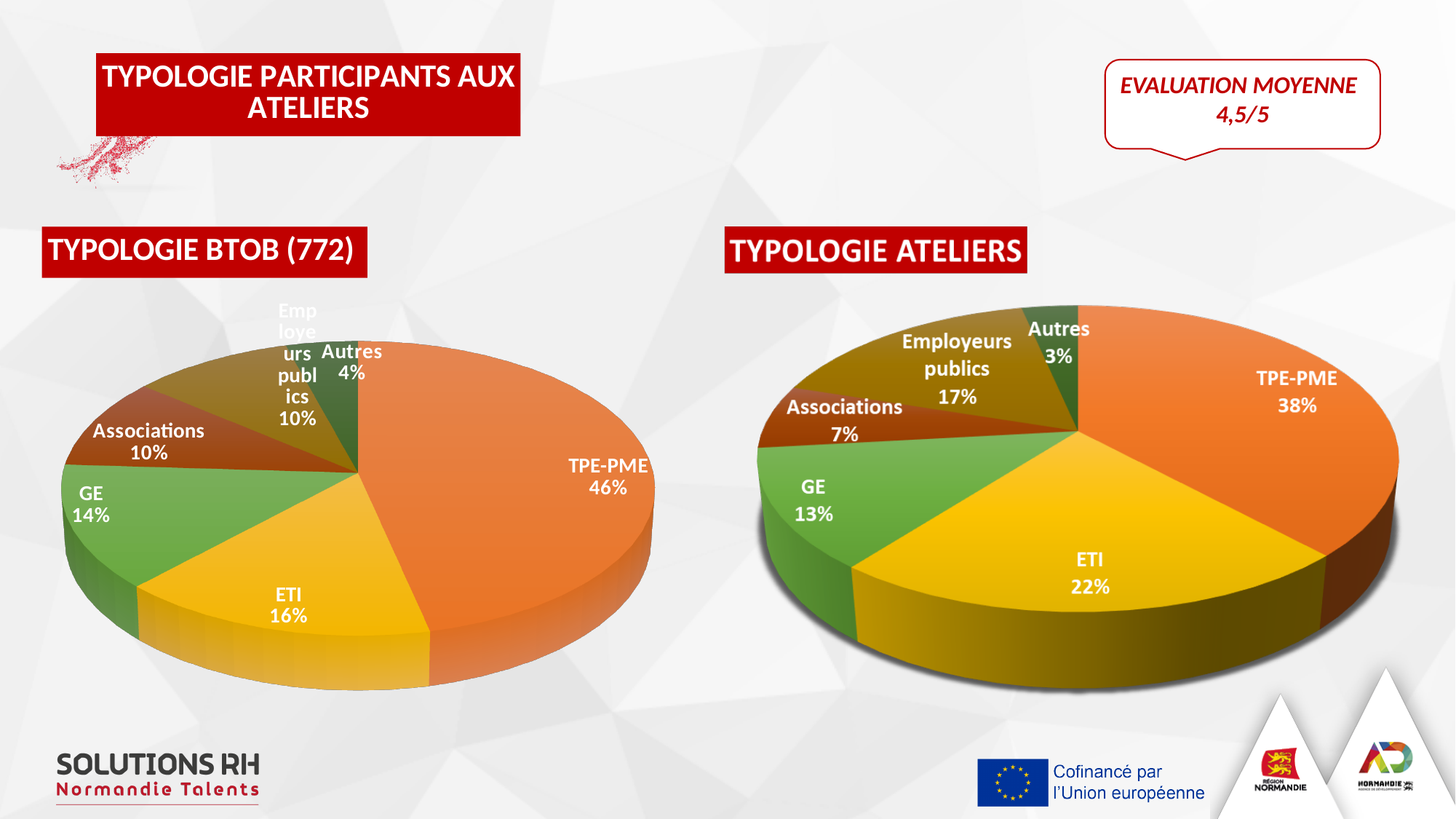
In the TYPOLOGIE BTOB (772) chart, what share does TPE-PME have? 46% How many categories does the TYPOLOGIE BTOB (772) chart show? 6 In the TYPOLOGIE ATELIERS chart, what is the difference between the TPE-PME share and the GE share? 25% In the TYPOLOGIE BTOB (772) chart, which category has the largest slice? TPE-PME What is the title of the chart on the left of the slide? TYPOLOGIE BTOB (772) In the TYPOLOGIE ATELIERS chart, which category has the smallest slice? Autres In the TYPOLOGIE ATELIERS chart, which is larger, the Associations slice or the Employeurs publics slice? Employeurs publics In the TYPOLOGIE ATELIERS chart, what share does ETI have? 22% In the TYPOLOGIE BTOB (772) chart, what is the difference between the TPE-PME share and the ETI share? 30% In the TYPOLOGIE BTOB (772) chart, which category has the smallest slice? Autres In the TYPOLOGIE ATELIERS chart, what share do Employeurs publics have? 17% What kind of chart is the TYPOLOGIE ATELIERS chart? Pie chart